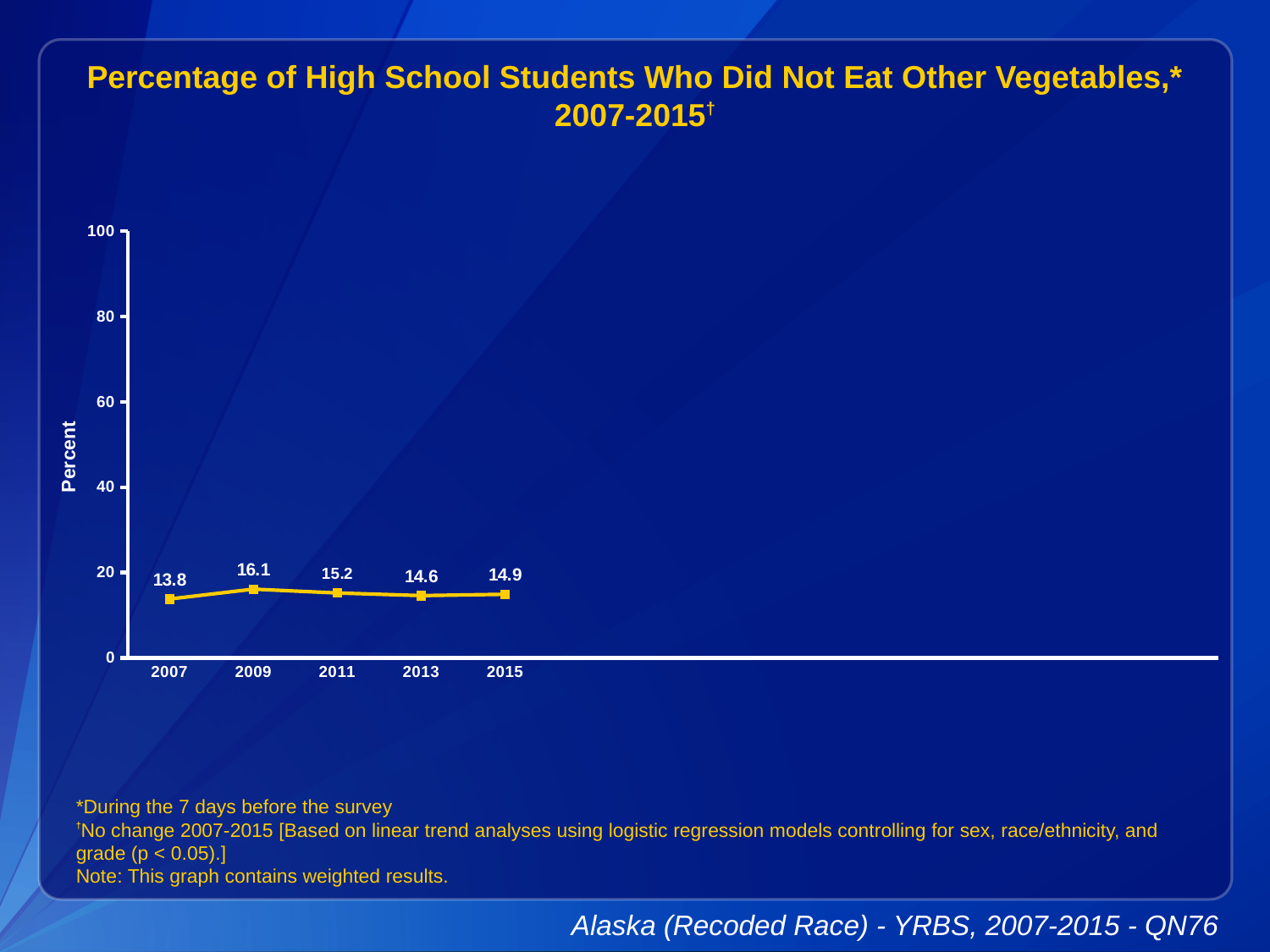
What kind of chart is shown on the slide? line chart Is the value for 2009 greater or less than 20? less What is the value plotted for 2015? 14.9 How many years are plotted on the chart? 5 What is the difference between the 2011 value and the 2013 value? 0.6 Which year has a larger value, 2013 or 2015? 2015 Which year has the lowest percentage? 2007 Which year has the highest percentage? 2009 What is the value plotted for 2011? 15.2 What is the difference between the 2009 value and the 2007 value? 2.3 What percentage of high school students did not eat other vegetables in 2007? 13.8 What is the label on the vertical axis? Percent